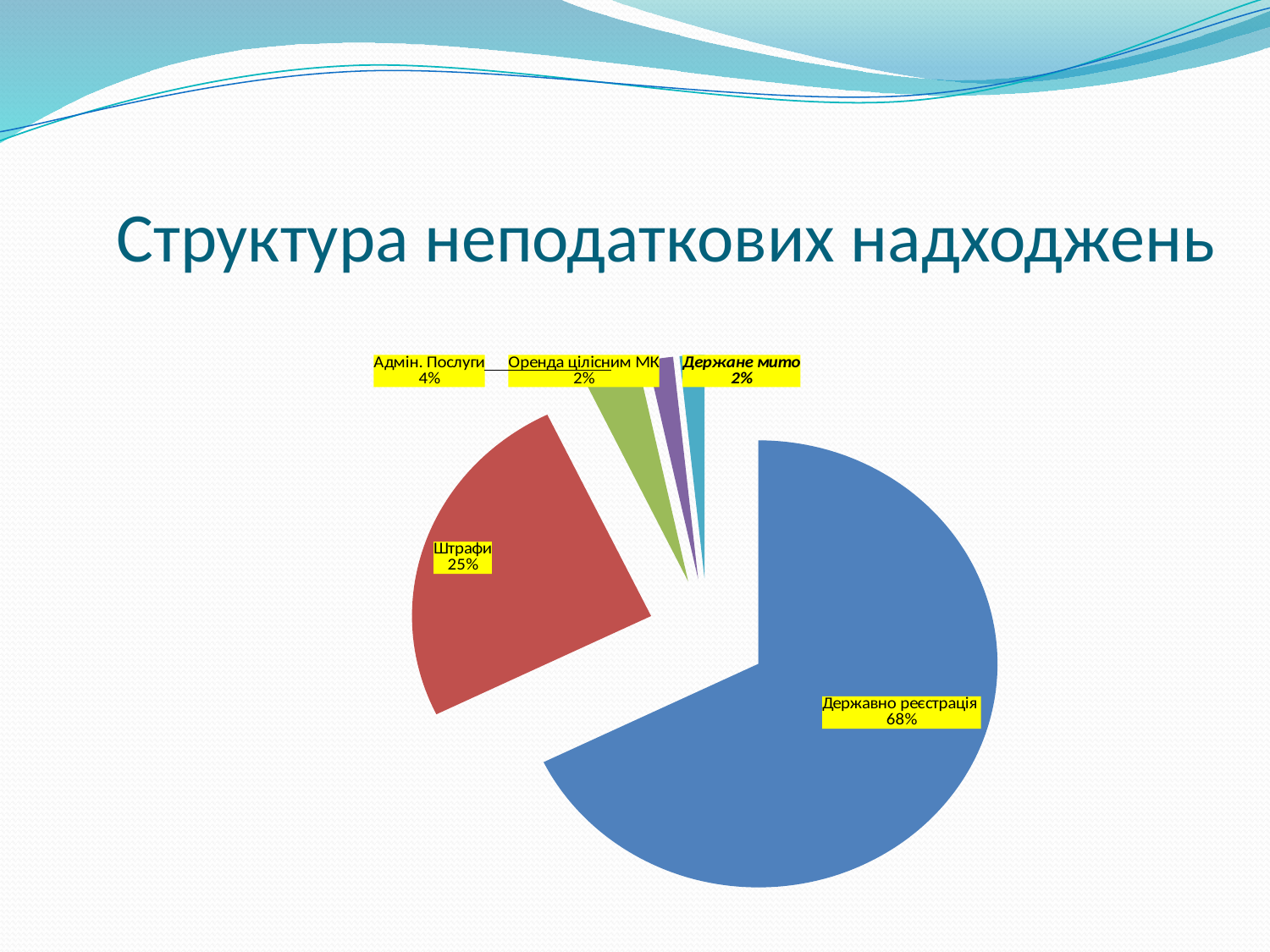
Which category has the largest slice of the pie? Державно реєстрація What is the difference in percentage points between Адмін. Послуги and Оренда цілісним МК? 2 What is the difference in percentage points between Державно реєстрація and Штрафи? 43 What kind of chart is shown on the slide? pie chart Which is larger, the share for Штрафи or the share for Адмін. Послуги? Штрафи What share of the pie does Штрафи take? 25% What share of the pie does Держане мито take? 2% What share of the pie does Державно реєстрація take? 68% How many slices does the pie chart have? 5 What share of the pie does Адмін. Послуги take? 4% What is the title of the chart on the slide? Структура неподаткових надходжень What colour is the slice for Штрафи? red